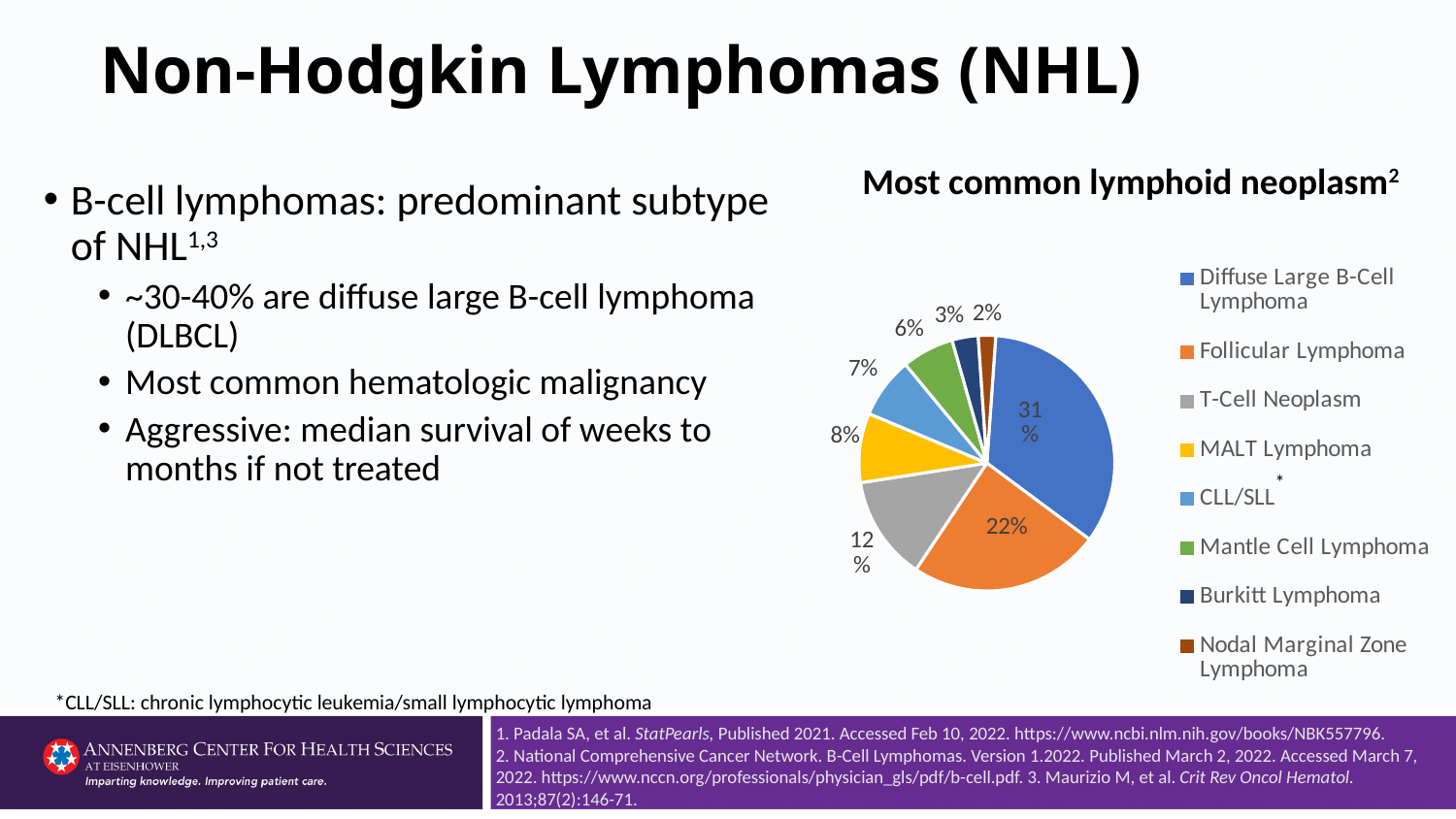
How many categories does the legend of the pie chart list? 8 What percentage of the pie is Follicular Lymphoma? 22% What percentage of the pie is MALT Lymphoma? 8% What is the title of the chart? Most common lymphoid neoplasm What type of chart is shown on the slide? Pie chart Which category has the largest share of the pie? Diffuse Large B-Cell Lymphoma What percentage of the pie is Diffuse Large B-Cell Lymphoma? 31% What is the difference in percentage points between Diffuse Large B-Cell Lymphoma and Follicular Lymphoma? 9 What percentage of the pie is Burkitt Lymphoma? 3% Which category has the smallest share of the pie? Nodal Marginal Zone Lymphoma Which is larger, the share for CLL/SLL or the share for Mantle Cell Lymphoma? CLL/SLL What percentage of the pie is T-Cell Neoplasm? 12%